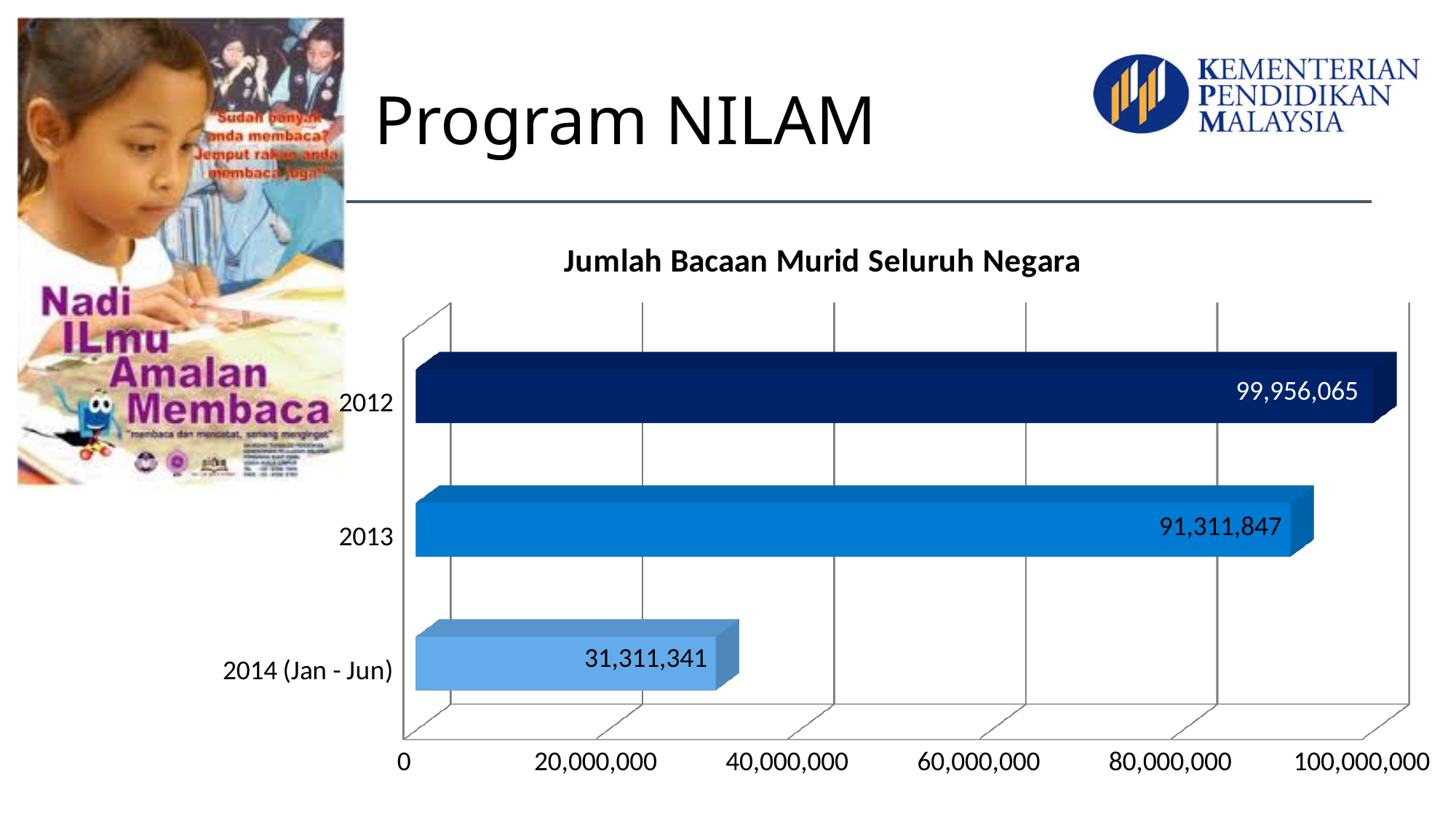
What is the title of the chart? Jumlah Bacaan Murid Seluruh Negara Which category has the highest value? 2012 Which category has the lowest value? 2014 (Jan - Jun) What is the value for 2013? 91,311,847 What is the difference between the values for 2013 and 2014 (Jan - Jun)? 60,000,506 Is the value for 2013 greater or less than 80,000,000? greater What is the value for 2012? 99,956,065 What is the value for 2014 (Jan - Jun)? 31,311,341 Which is larger, the value for 2013 or the value for 2014 (Jan - Jun)? 2013 How many categories are shown in the chart? 3 What is the difference between the values for 2012 and 2013? 8,644,218 What kind of chart is shown on the slide? bar chart